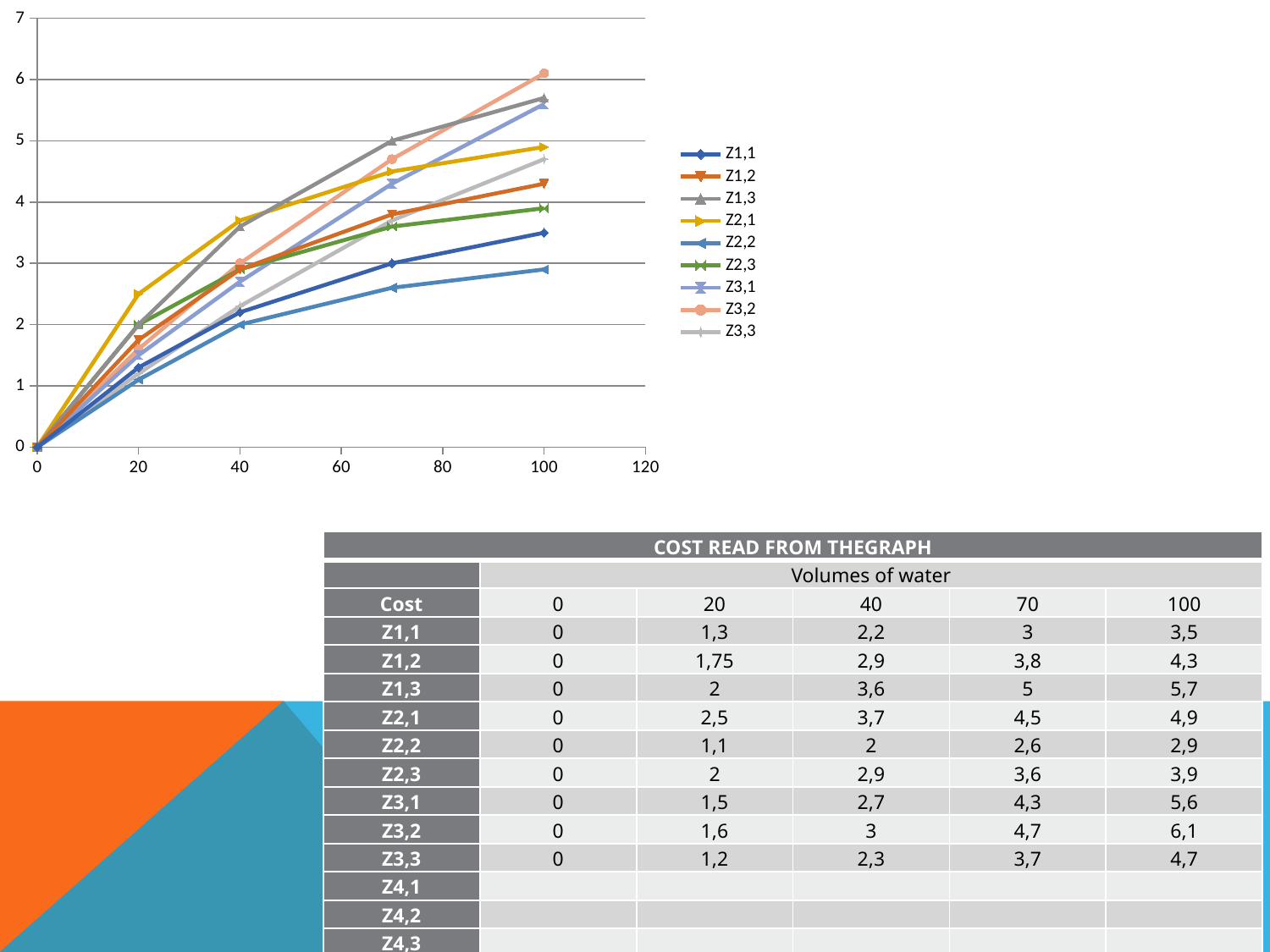
What is the difference between Z1,3 and Z1,1 at a volume of 100? 2,2 Which series has the highest value at a volume of 20? Z2,1 At a volume of 40, which is larger: Z2,1 or Z1,2? Z2,1 Which series has the highest value at a volume of 100? Z3,2 What is the value of Z1,3 at a volume of 70? 5 Do the series values rise or fall as the volume of water increases? rise What is the value of Z3,2 at a volume of 100? 6,1 Which series has the lowest value at a volume of 100? Z2,2 How many series does the chart's legend list? 9 What kind of chart is shown on the slide? line chart How many data points does each series have along the x axis? 5 Is the value for Z3,1 at a volume of 100 greater or less than 5? greater